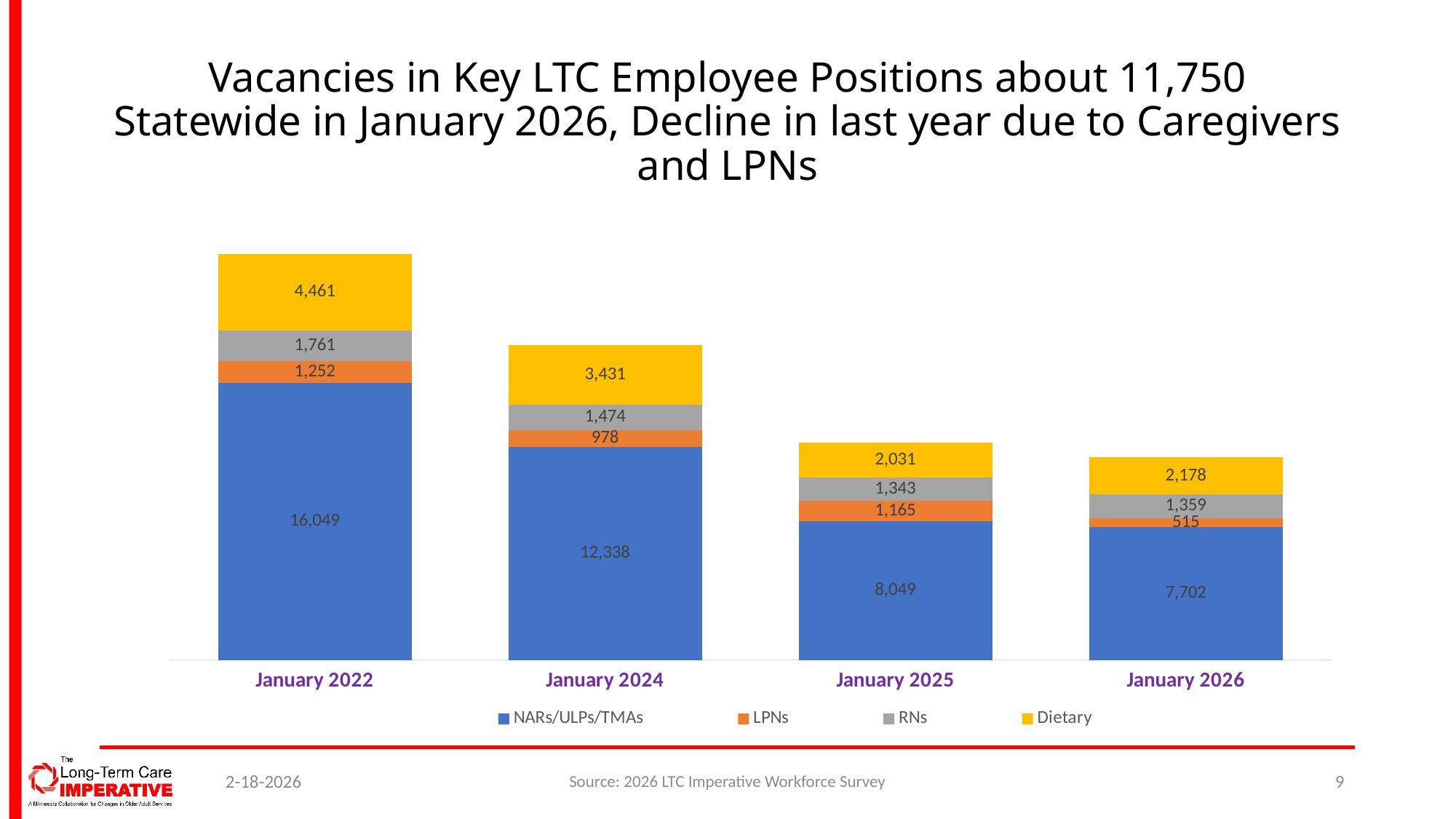
In which year is the LPNs value lowest? January 2026 What is the value for Dietary in January 2024? 3,431 What is the value for NARs/ULPs/TMAs in January 2022? 16,049 What kind of chart is shown on the slide? Stacked bar chart What is the difference between the NARs/ULPs/TMAs values for January 2022 and January 2024? 3,711 In which year is the NARs/ULPs/TMAs value highest? January 2022 What is the total of the stacked bar for January 2026? 11,754 How many time periods are shown on the x axis? 4 Which is larger, the Dietary value in January 2025 or in January 2026? January 2026 What is the value for LPNs in January 2026? 515 What is the value for RNs in January 2025? 1,343 How many series does the legend list? 4